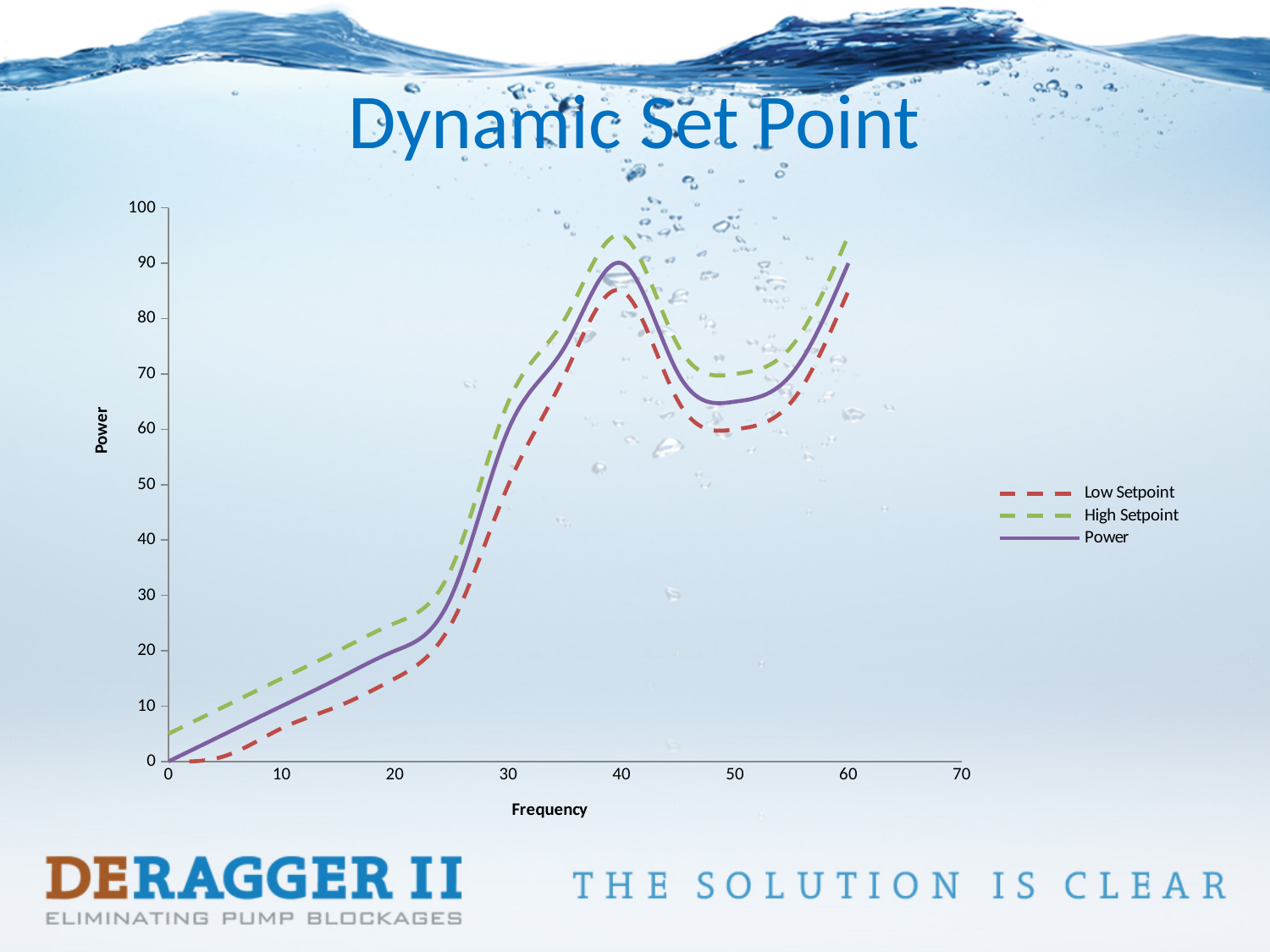
How many series does the legend list? 3 At which frequency does the Power series reach its highest value? 40 and 60 Is the value of the Power series at frequency 40 greater or less than 80? greater Is the value of the High Setpoint series at frequency 40 greater or less than 90? greater What is the title of the chart? Dynamic Set Point What are the three series listed in the legend? Low Setpoint, High Setpoint, Power Is the value of the Low Setpoint series at frequency 50 greater or less than 70? less At frequency 40, which series has the larger value, High Setpoint or Low Setpoint? High Setpoint Does the Power series rise or fall as frequency increases from 0 to 40? Rise What kind of chart is shown on the slide? Line chart